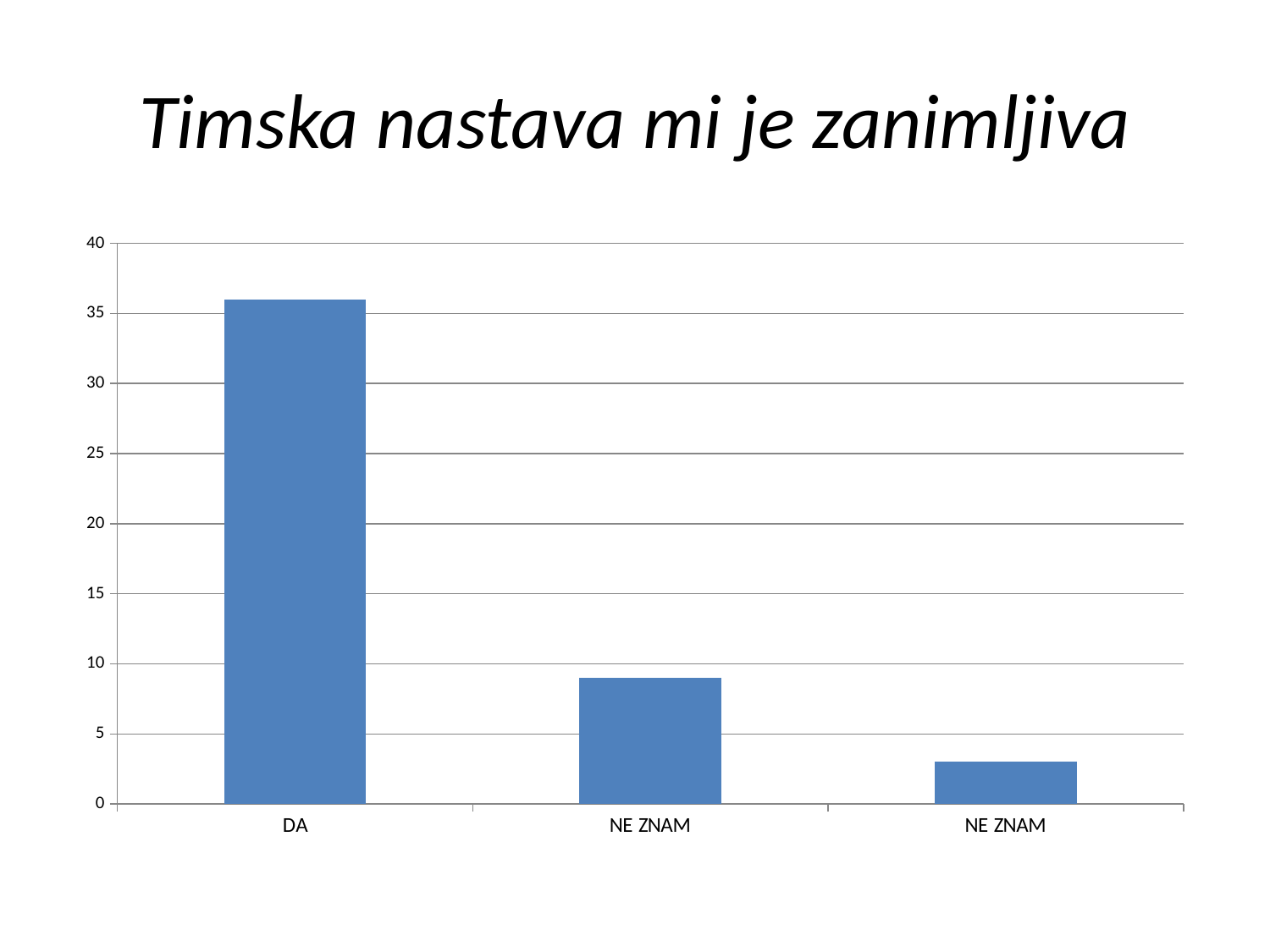
Which bar has the lowest value? the rightmost NE ZNAM bar Is the value for the middle bar (NE ZNAM) greater or less than 5? greater What kind of chart is shown on the slide? bar chart How many bars (categories) does the chart show? 3 Is the value for DA greater or less than 30? greater What is the title of the chart on the slide? Timska nastava mi je zanimljiva What is the highest value shown on the vertical axis? 40 Do the bar values rise or fall from left to right along the x axis? fall Is the value for the rightmost bar (NE ZNAM) greater or less than 5? less Which is larger, the value for DA or the value for the middle NE ZNAM bar? DA Which category has the highest value? DA